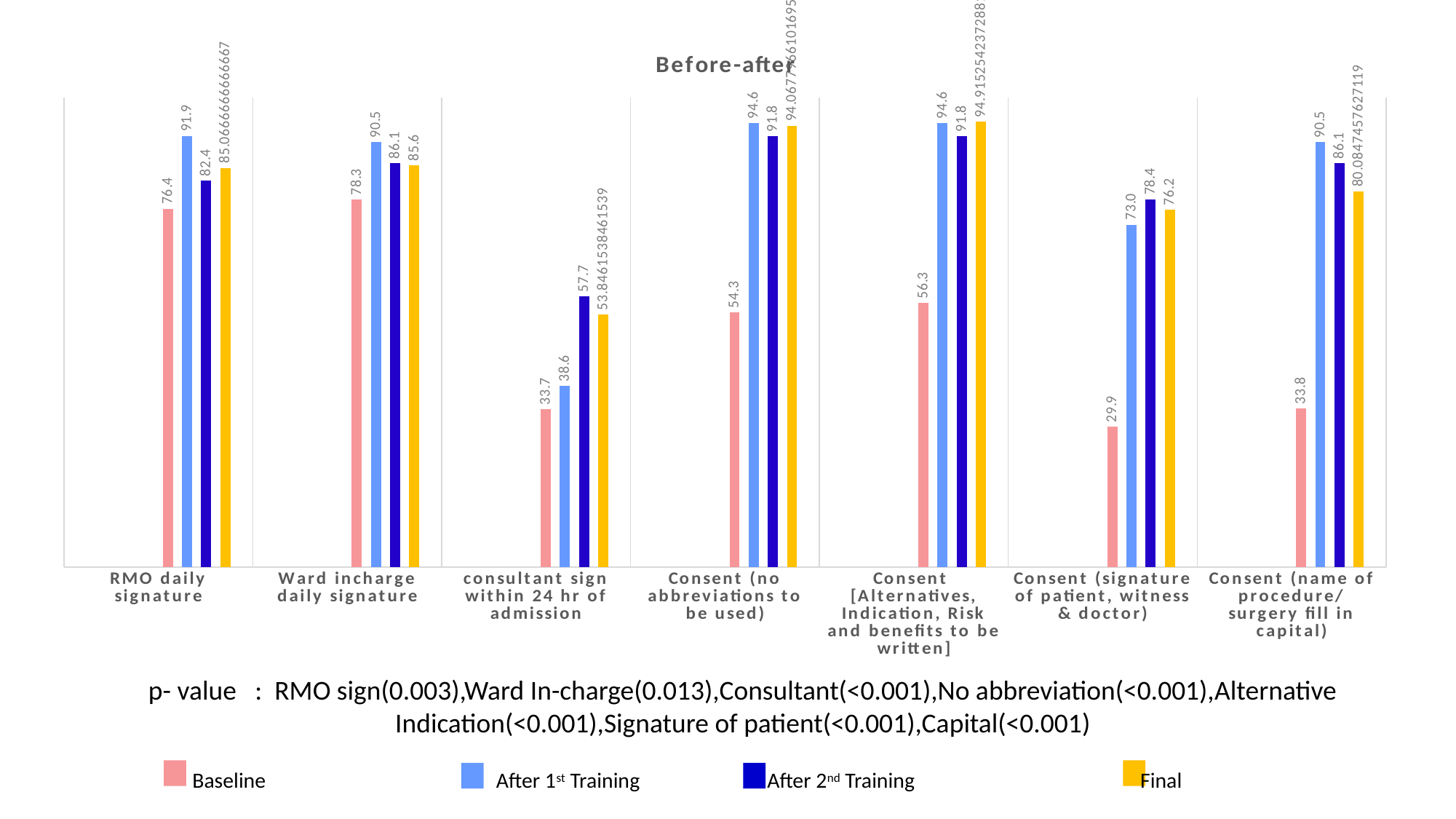
For Consent (signature of patient, witness & doctor), which is larger: the After 1st Training value or the After 2nd Training value? After 2nd Training How many series does the legend list? 4 Which category has the lowest After 1st Training value? consultant sign within 24 hr of admission Which category has the lowest Baseline value? Consent (signature of patient, witness & doctor) What is the Baseline value for RMO daily signature? 76.4 What is the After 1st Training value for Ward incharge daily signature? 90.5 What kind of chart is shown on the slide? Bar chart How many categories are shown on the x axis? 7 What is the difference between the After 1st Training and Baseline values for Consent (no abbreviations to be used)? 40.3 What is the After 2nd Training value for consultant sign within 24 hr of admission? 57.7 What is the Final value for Consent (signature of patient, witness & doctor)? 76.2 What is the Baseline value for Consent (name of procedure/surgery fill in capital)? 33.8